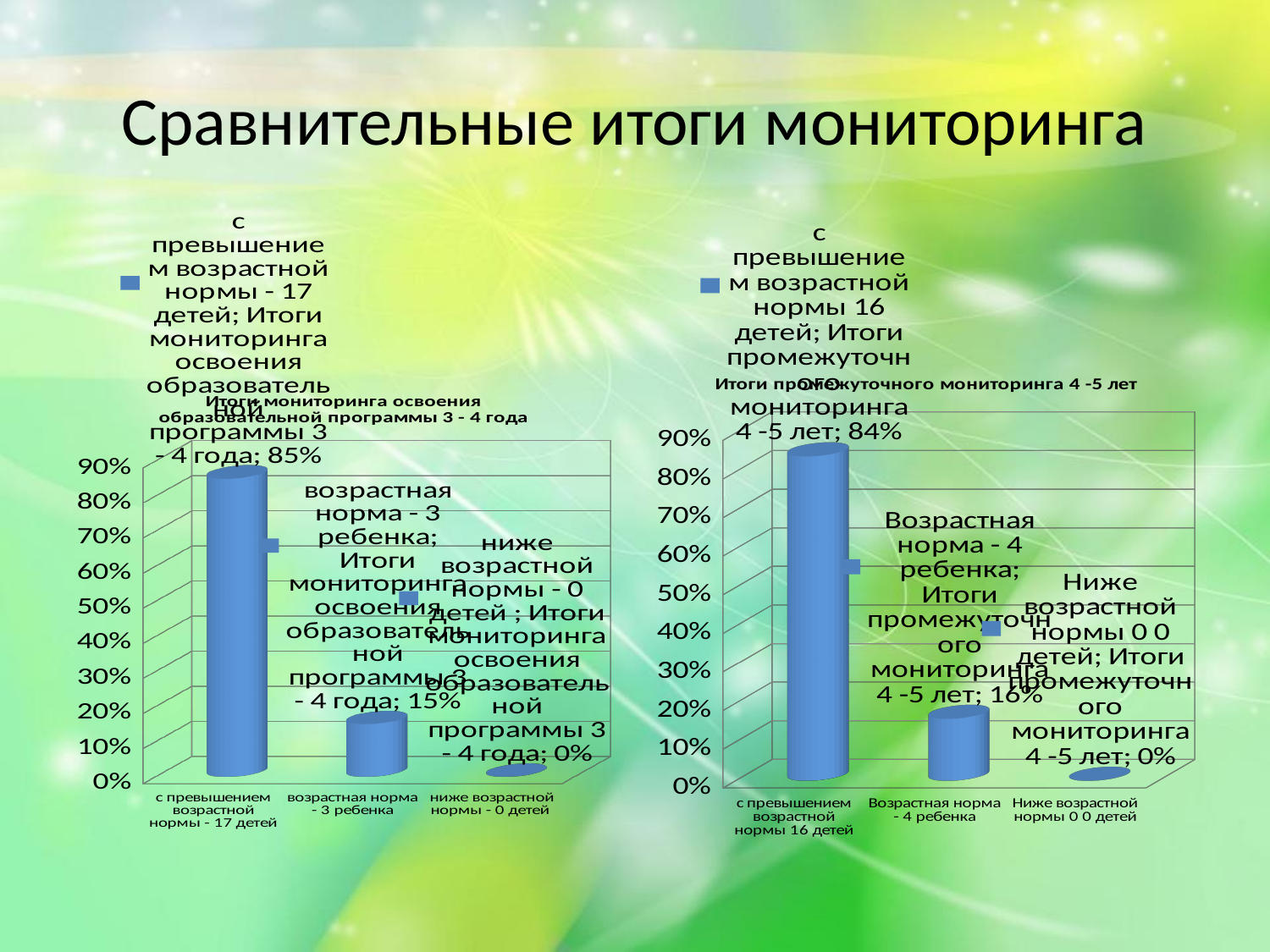
In the left chart (3 - 4 года), what is the value for 'возрастная норма - 3 ребенка'? 15% In the left chart (3 - 4 года), which category has the highest value? с превышением возрастной нормы - 17 детей In the left chart (3 - 4 года), what is the difference between the values for 'с превышением возрастной нормы - 17 детей' and 'возрастная норма - 3 ребенка'? 70% Which is larger: the value for 'с превышением возрастной нормы' in the left chart (3 - 4 года) or in the right chart (4 -5 лет)? Left chart (85%) In the right chart (4 -5 лет), what is the value for 'Ниже возрастной нормы 0 0 детей'? 0% In the left chart (Итоги мониторинга освоения образовательной программы 3 - 4 года), what is the value for 'с превышением возрастной нормы - 17 детей'? 85% In the right chart (Итоги промежуточного мониторинга 4 -5 лет), what is the value for 'с превышением возрастной нормы 16 детей'? 84% What type of chart is the left chart (3 - 4 года)? Bar chart How many categories are shown in the right chart (4 -5 лет)? 3 In the right chart (4 -5 лет), what is the value for 'Возрастная норма - 4 ребенка'? 16% In the right chart (4 -5 лет), which category has the lowest value? Ниже возрастной нормы 0 0 детей In the right chart (4 -5 лет), what is the difference between the values for 'с превышением возрастной нормы 16 детей' and 'Возрастная норма - 4 ребенка'? 68%